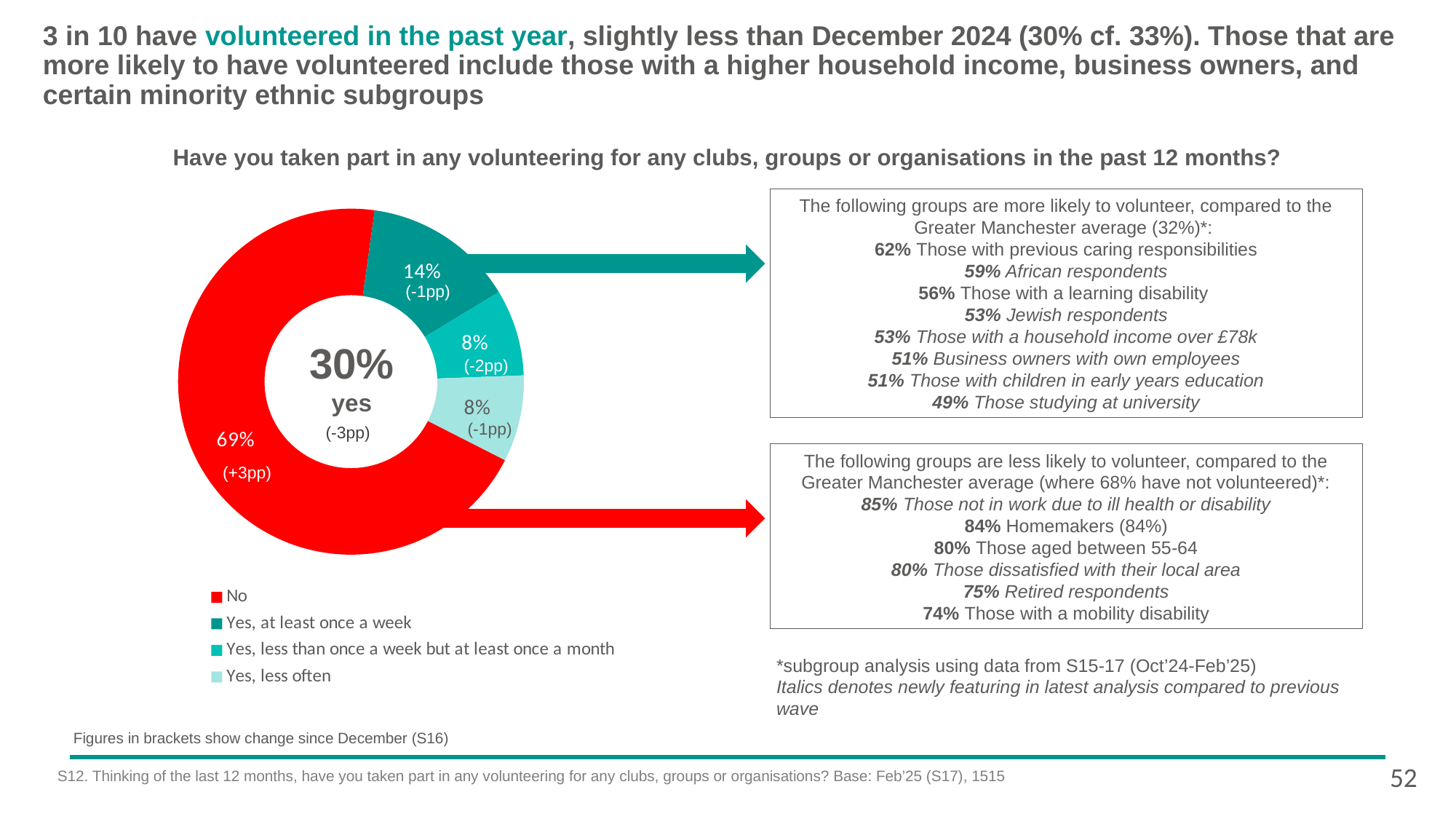
What percentage of respondents answered "No" to taking part in volunteering in the past 12 months? 69% How many categories does the legend of the donut chart list? 4 What type of chart is shown on the slide? Pie chart (donut) What is the overall percentage shown in the centre of the donut chart for those who said yes? 30% Which is larger: the share for "Yes, at least once a week" or the share for "Yes, less often"? Yes, at least once a week What colour is used for the "No" slice of the donut chart? Red What change since December is shown in brackets for the "No" slice? +3pp What percentage of respondents said "Yes, at least once a week"? 14% What percentage of respondents said "Yes, less often"? 8% Which category has the largest share of the donut chart? No What change since December is shown in brackets for the overall "yes" figure in the centre of the chart? -3pp What is the difference in percentage points between the "No" slice and the "Yes, at least once a week" slice? 55 percentage points